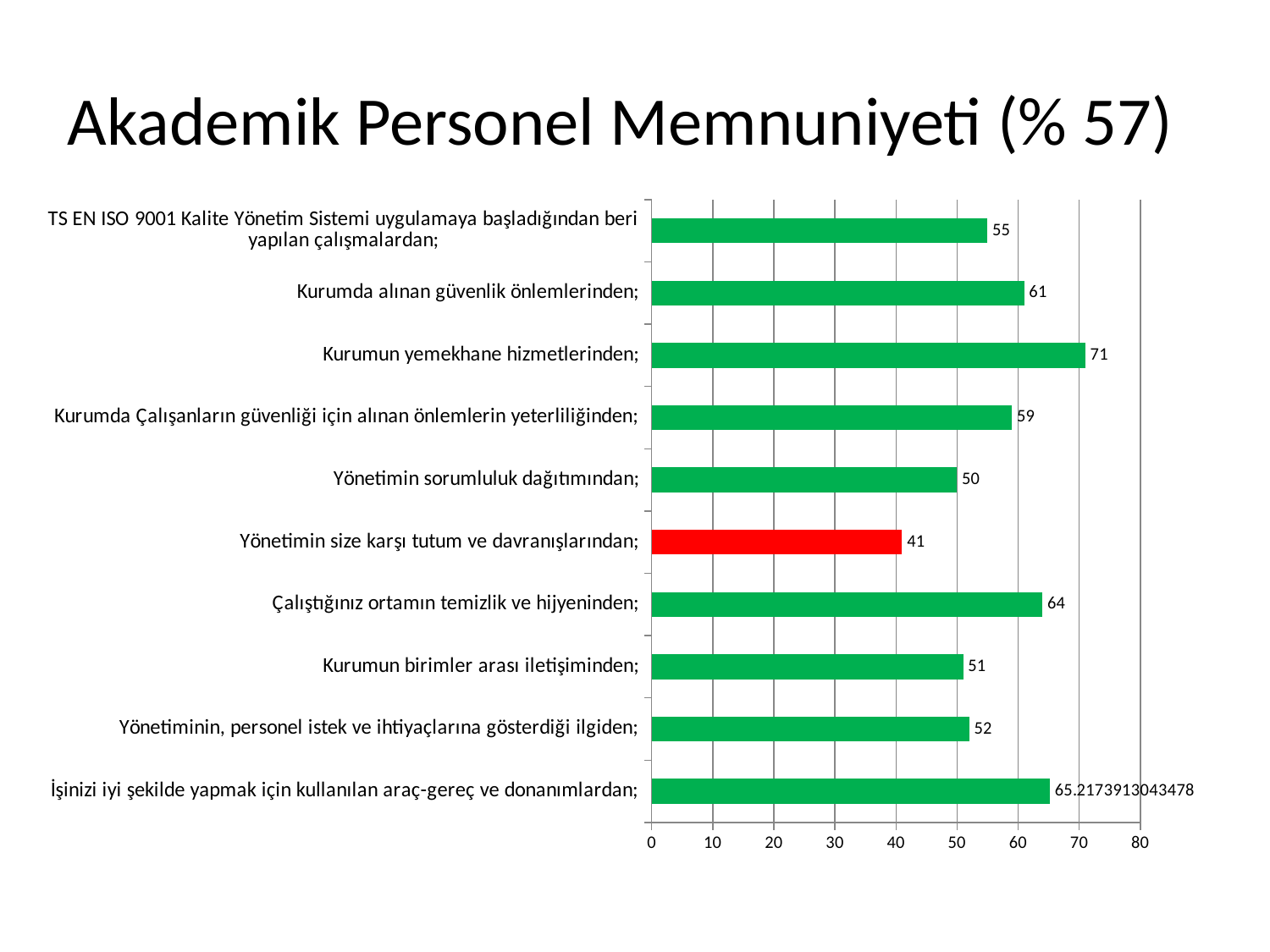
What is the value for "Kurumun yemekhane hizmetlerinden;"? 71 What is the value for "Yönetimin size karşı tutum ve davranışlarından;"? 41 Which category's bar is coloured red? Yönetimin size karşı tutum ve davranışlarından; Which is larger: the value for "Kurumda alınan güvenlik önlemlerinden;" or the value for "Yönetimin sorumluluk dağıtımından;"? Kurumda alınan güvenlik önlemlerinden; How many categories are shown in the chart? 10 What is the value for "Kurumda alınan güvenlik önlemlerinden;"? 61 What is the value for "Çalıştığınız ortamın temizlik ve hijyeninden;"? 64 What is the title of the slide? Akademik Personel Memnuniyeti (% 57) Which category has the lowest value? Yönetimin size karşı tutum ve davranışlarından; Which category has the highest value? Kurumun yemekhane hizmetlerinden; What is the difference between the values for "Kurumun yemekhane hizmetlerinden;" and "Yönetimin size karşı tutum ve davranışlarından;"? 30 What type of chart is shown on the slide? Bar chart